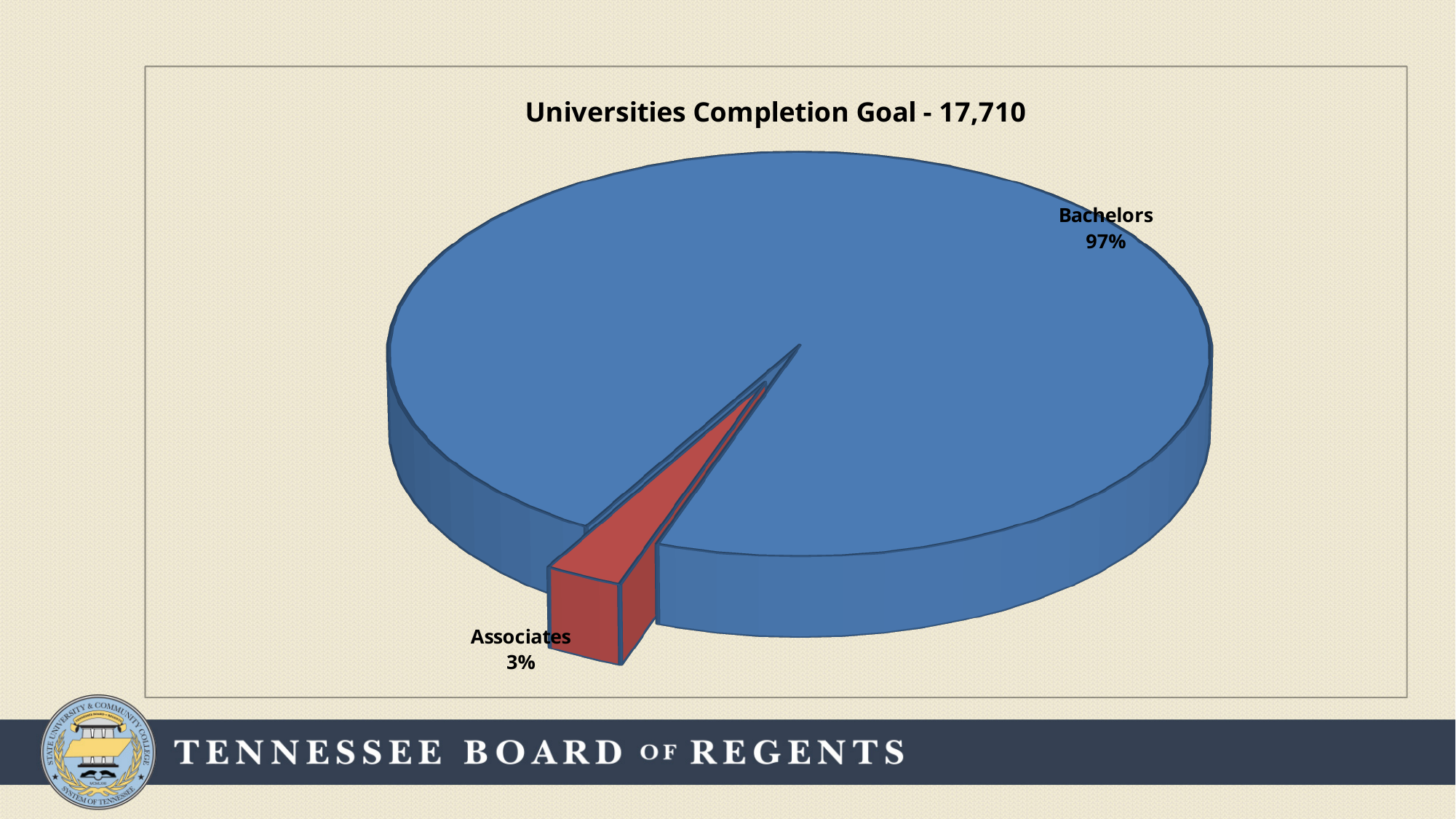
What is the difference in percentage points between the Bachelors and Associates slices? 94 What kind of chart is shown on the slide? Pie chart What share of the pie does Associates represent? 3% How many slices does the pie chart have? 2 What is the total completion goal number shown in the chart title? 17,710 What colour is the Associates slice? Red Which category has the largest slice of the pie? Bachelors What share of the pie does Bachelors represent? 97% What is the title of the chart? Universities Completion Goal - 17,710 Which category has the smallest slice of the pie? Associates Which slice is larger, Bachelors or Associates? Bachelors